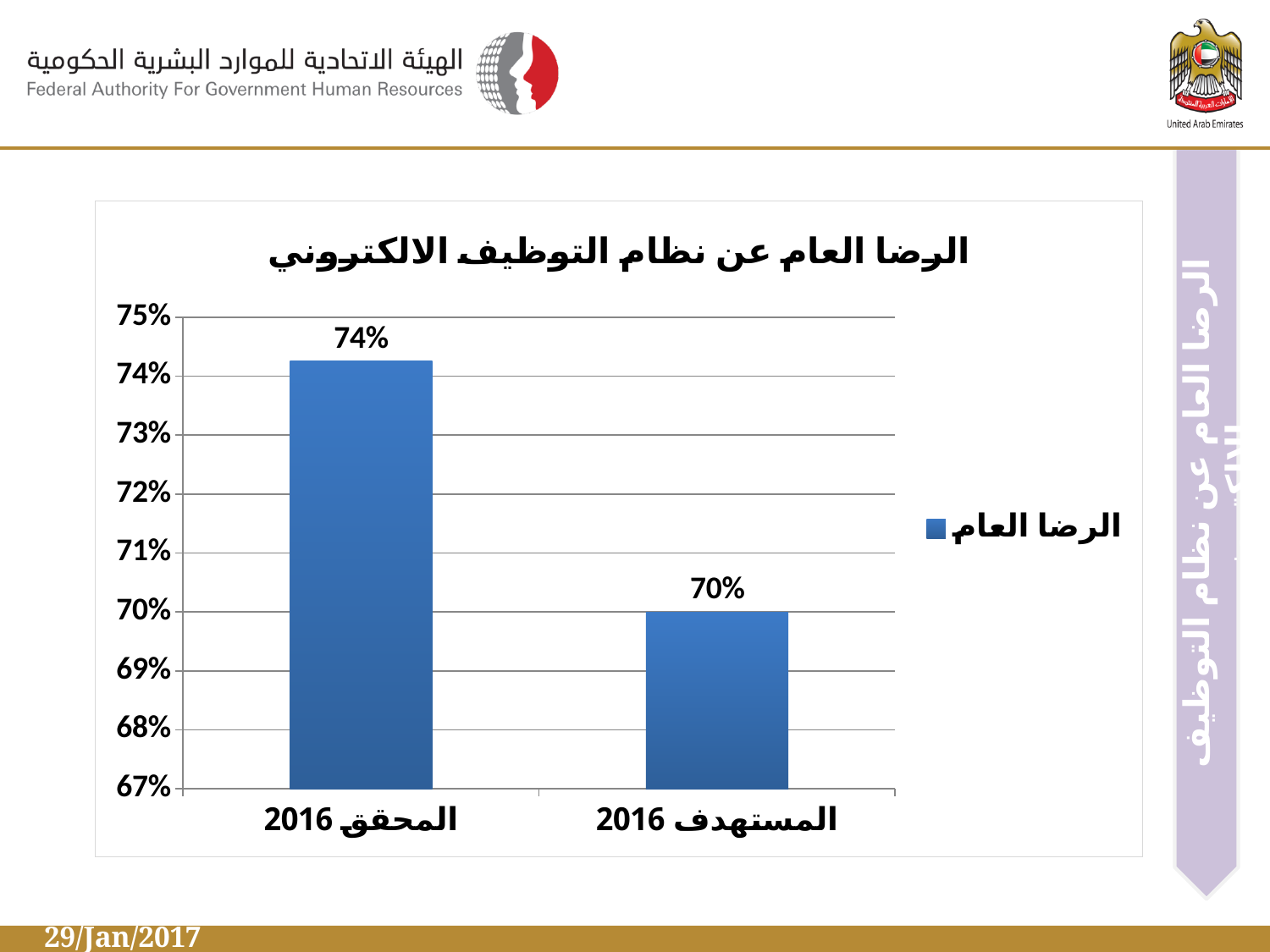
Which category has the lowest value? المستهدف 2016 What is the title of the chart? الرضا العام عن نظام التوظيف الالكتروني What is the value for المستهدف 2016? 70% What is the value for المحقق 2016? 74% Is the value for المحقق 2016 greater or less than 72%? greater Is the value for المستهدف 2016 greater or less than 72%? less Which is larger, the value for المحقق 2016 or the value for المستهدف 2016? المحقق 2016 Which category has the highest value? المحقق 2016 What kind of chart is shown on the slide? bar chart How many categories are shown on the x axis? 2 How many series does the legend list? 1 What is the difference between the values for المحقق 2016 and المستهدف 2016? 4%